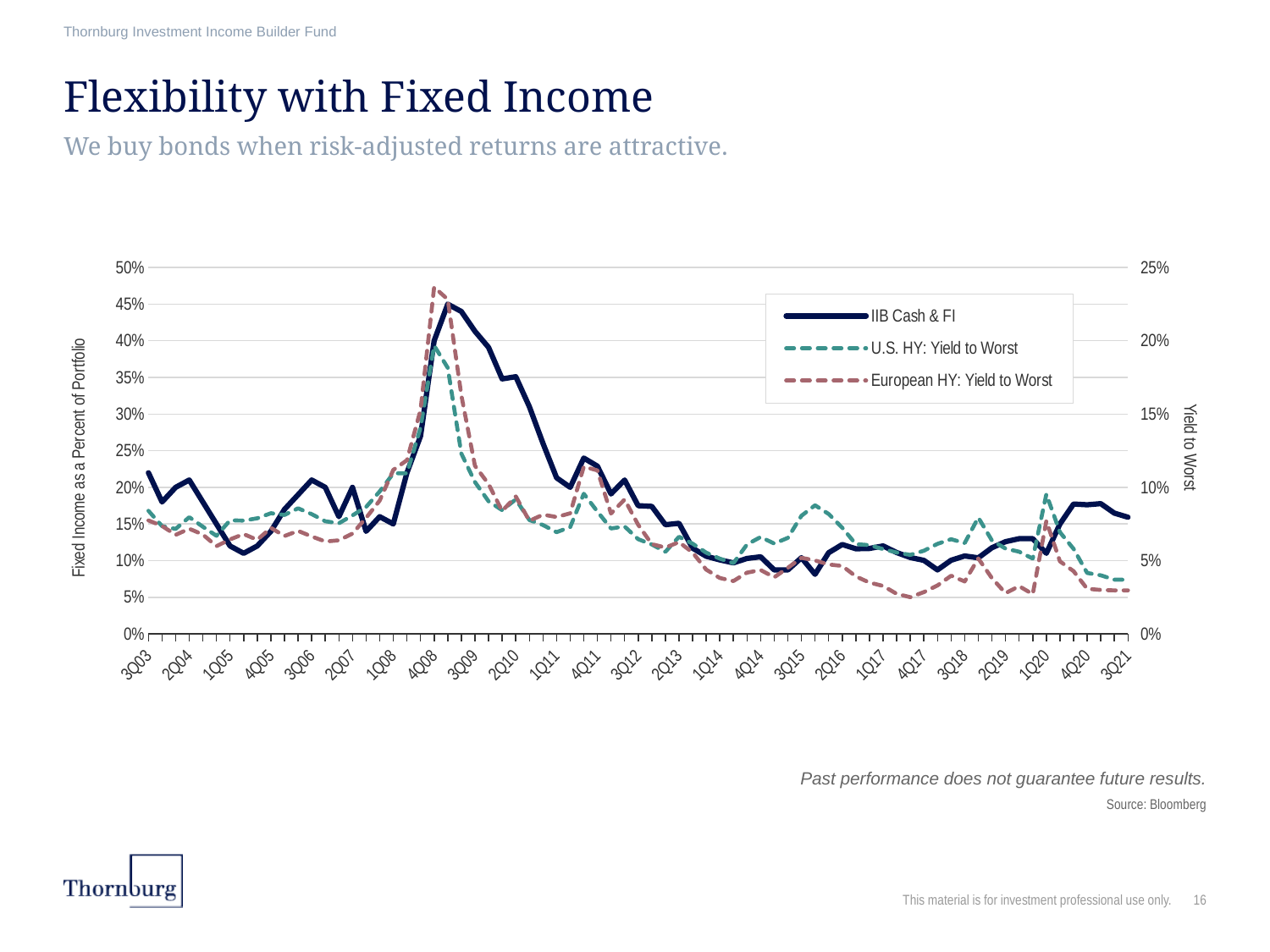
Does the IIB Cash & FI line rise or fall between 2Q07 and 4Q08? rise Is the value of IIB Cash & FI at 1Q05 greater or less than 15% on the left axis? less What kind of chart is shown on the slide? line chart What is the title of the right-hand vertical axis of the chart? Yield to Worst Does the IIB Cash & FI line rise or fall between 4Q08 and 1Q14? fall Which series is drawn as a solid line in the chart? IIB Cash & FI How many series does the chart's legend list? 3 Is the peak value of U.S. HY: Yield to Worst around 4Q08 greater or less than 15% on the right axis? greater Is the value of IIB Cash & FI at 3Q21 greater or less than 10% on the left axis? greater At the 4Q08 peak, which series is higher: U.S. HY: Yield to Worst or European HY: Yield to Worst? European HY: Yield to Worst